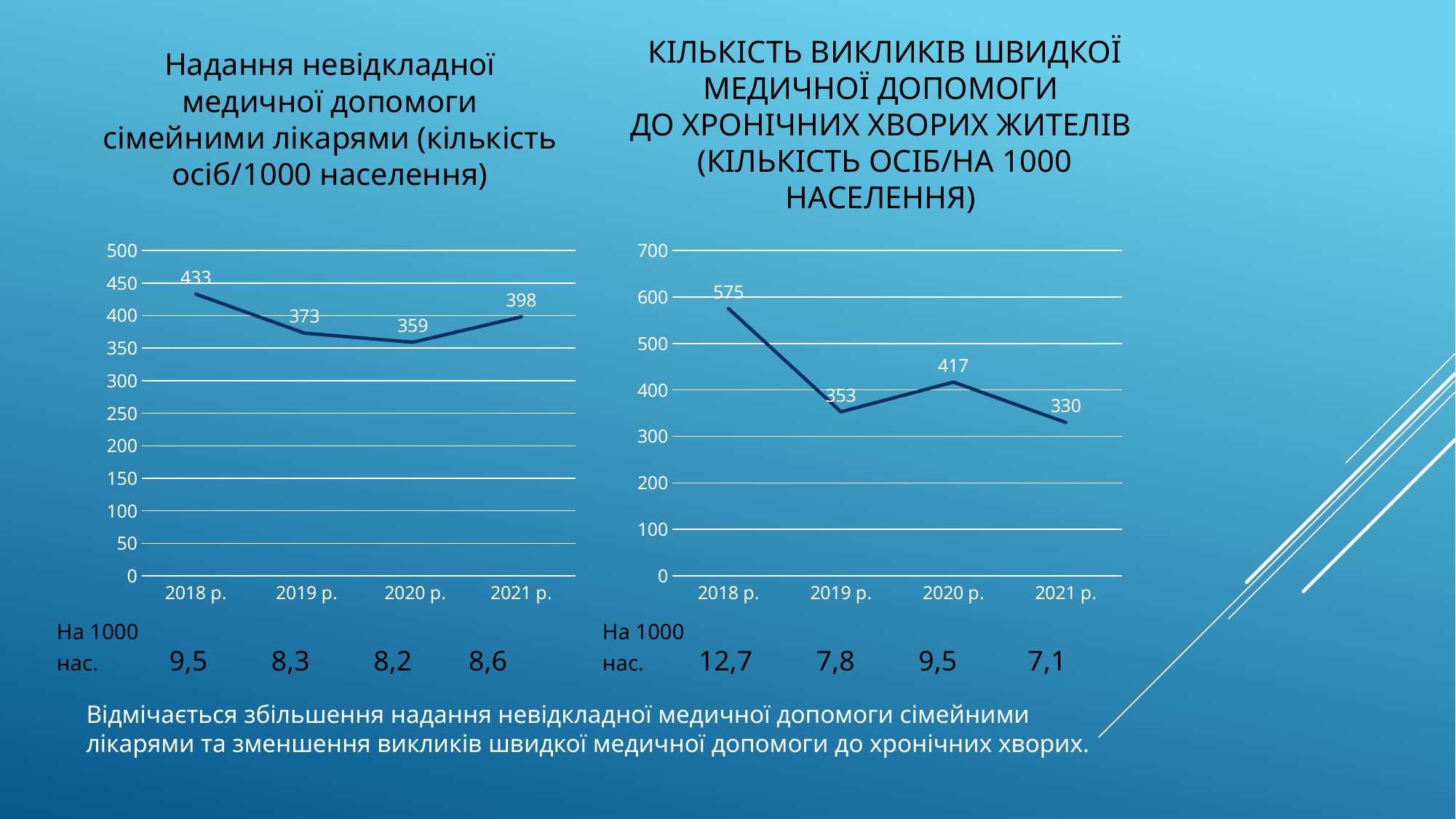
In the right chart (Кількість викликів швидкої медичної допомоги до хронічних хворих жителів), which is larger: the value for 2019 р. or 2020 р.? 2020 р. In the right chart (Кількість викликів швидкої медичної допомоги до хронічних хворих жителів), what is the value for 2021 р.? 330 In the left chart (Надання невідкладної медичної допомоги сімейними лікарями), how many data points are plotted? 4 In the right chart (Кількість викликів швидкої медичної допомоги до хронічних хворих жителів), what is the value for 2018 р.? 575 In the right chart (Кількість викликів швидкої медичної допомоги до хронічних хворих жителів), what is the difference between the values for 2018 р. and 2021 р.? 245 In the left chart (Надання невідкладної медичної допомоги сімейними лікарями), what is the value for 2020 р.? 359 In the right chart (Кількість викликів швидкої медичної допомоги до хронічних хворих жителів), which year has the highest value? 2018 р. In the right chart (Кількість викликів швидкої медичної допомоги до хронічних хворих жителів), is the value for 2020 р. greater or less than 400? greater In the left chart (Надання невідкладної медичної допомоги сімейними лікарями), what is the value for 2018 р.? 433 In the left chart (Надання невідкладної медичної допомоги сімейними лікарями), what is the difference between the values for 2018 р. and 2019 р.? 60 In the left chart (Надання невідкладної медичної допомоги сімейними лікарями), which year has the lowest value? 2020 р. What type of chart is the right chart (Кількість викликів швидкої медичної допомоги до хронічних хворих жителів)? Line chart